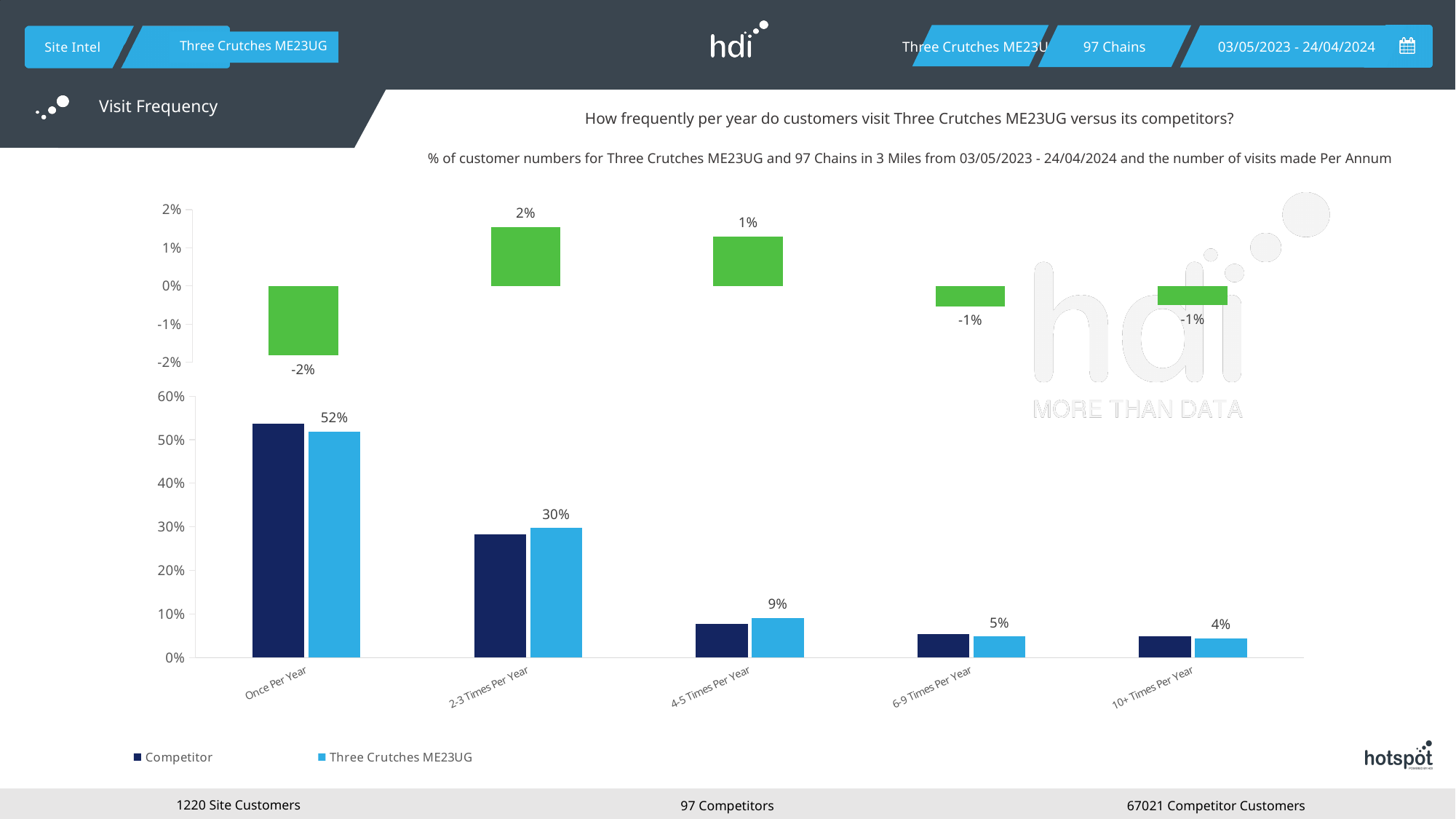
In the top chart, what is the value for 2-3 Times Per Year? 2% In the bottom chart, what is the value for Three Crutches ME23UG for 2-3 Times Per Year? 30% In the bottom chart, what is the value for Three Crutches ME23UG for Once Per Year? 52% In the bottom chart, which category has the lowest value for Three Crutches ME23UG? 10+ Times Per Year In the bottom chart, what is the value for Three Crutches ME23UG for 10+ Times Per Year? 4% In the bottom chart, which category has the highest value for Three Crutches ME23UG? Once Per Year In the bottom chart, is the Competitor value for Once Per Year greater or less than 50%? greater In the bottom chart, is the Competitor value for 4-5 Times Per Year greater or less than 10%? less In the bottom chart, what is the difference between the Three Crutches ME23UG values for Once Per Year and 2-3 Times Per Year? 22% In the top chart, what is the value for Once Per Year? -2% How many series does the legend of the bottom chart list? 2 How many categories are shown on the x axis of the bottom chart? 5